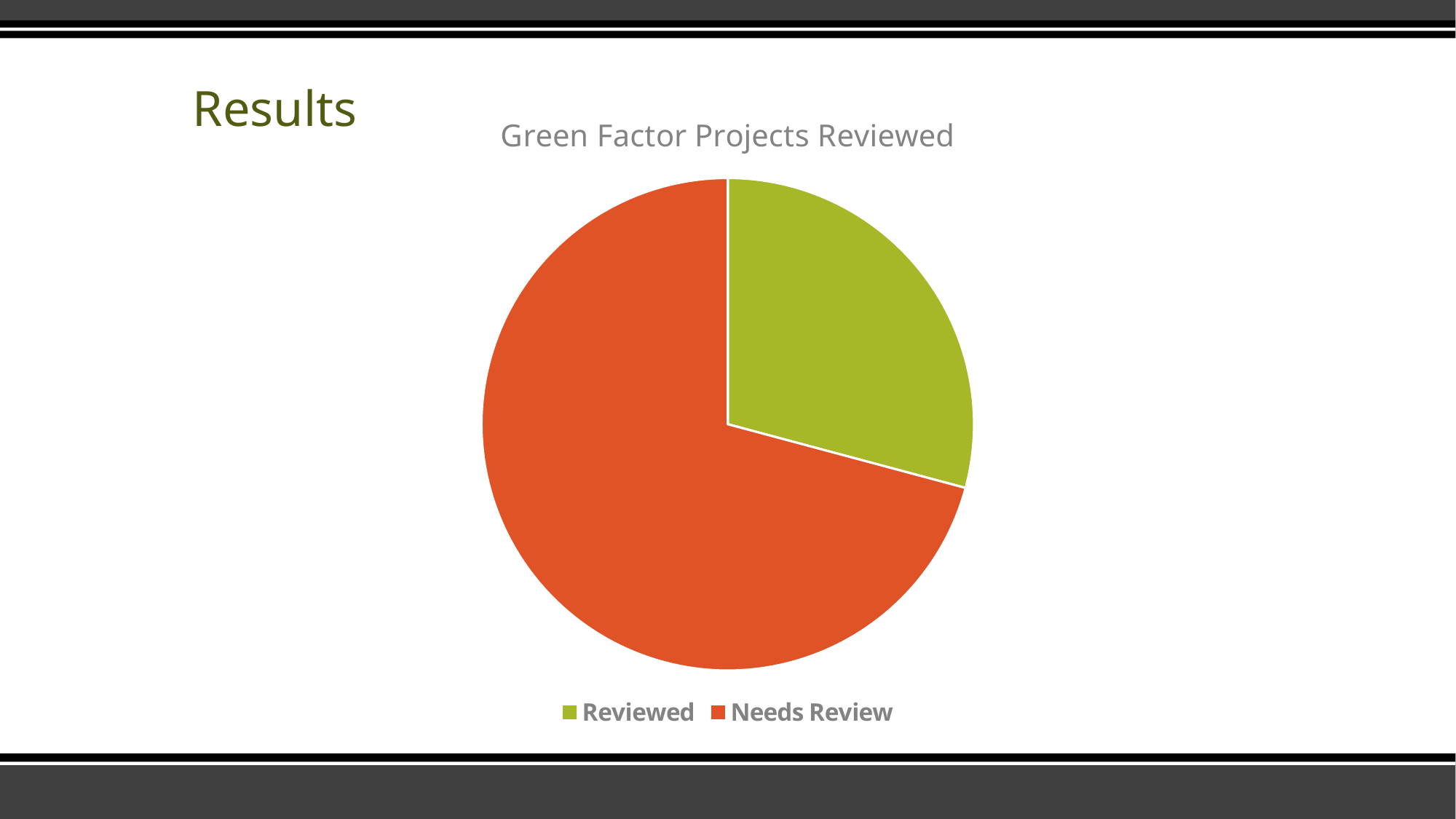
What colour is the Reviewed slice? green What is the title of the chart? Green Factor Projects Reviewed How many entries does the legend list? 2 Which slice of the pie is the smallest? Reviewed Which slice of the pie is the largest? Needs Review What kind of chart is shown on the slide? pie chart Which is larger, the Reviewed slice or the Needs Review slice? Needs Review How many slices does the pie chart have? 2